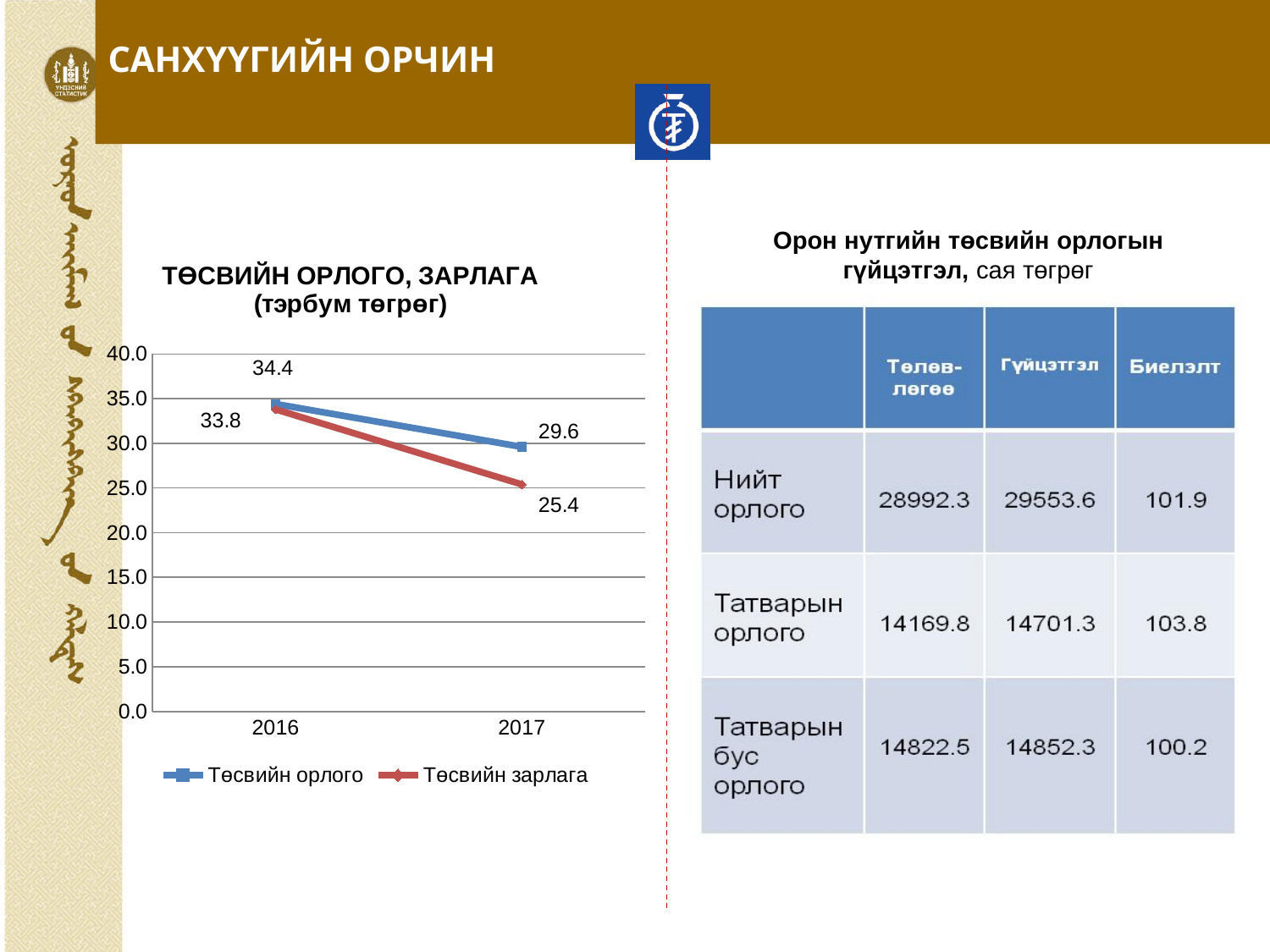
How many series does the legend list? 2 What is the value of Төсвийн зарлага in 2016? 33.8 What is the value of Төсвийн орлого in 2016? 34.4 What is the value of Төсвийн зарлага in 2017? 25.4 Does Төсвийн орлого rise or fall from 2016 to 2017? fall What type of chart is shown on the slide? line chart What is the difference between Төсвийн орлого and Төсвийн зарлага in 2017? 4.2 What is the value of Төсвийн орлого in 2017? 29.6 Which is larger in 2017, Төсвийн орлого or Төсвийн зарлага? Төсвийн орлого What unit is given in the chart title? тэрбум төгрөг By how much did Төсвийн зарлага decrease from 2016 to 2017? 8.4 How many years are shown on the x axis? 2